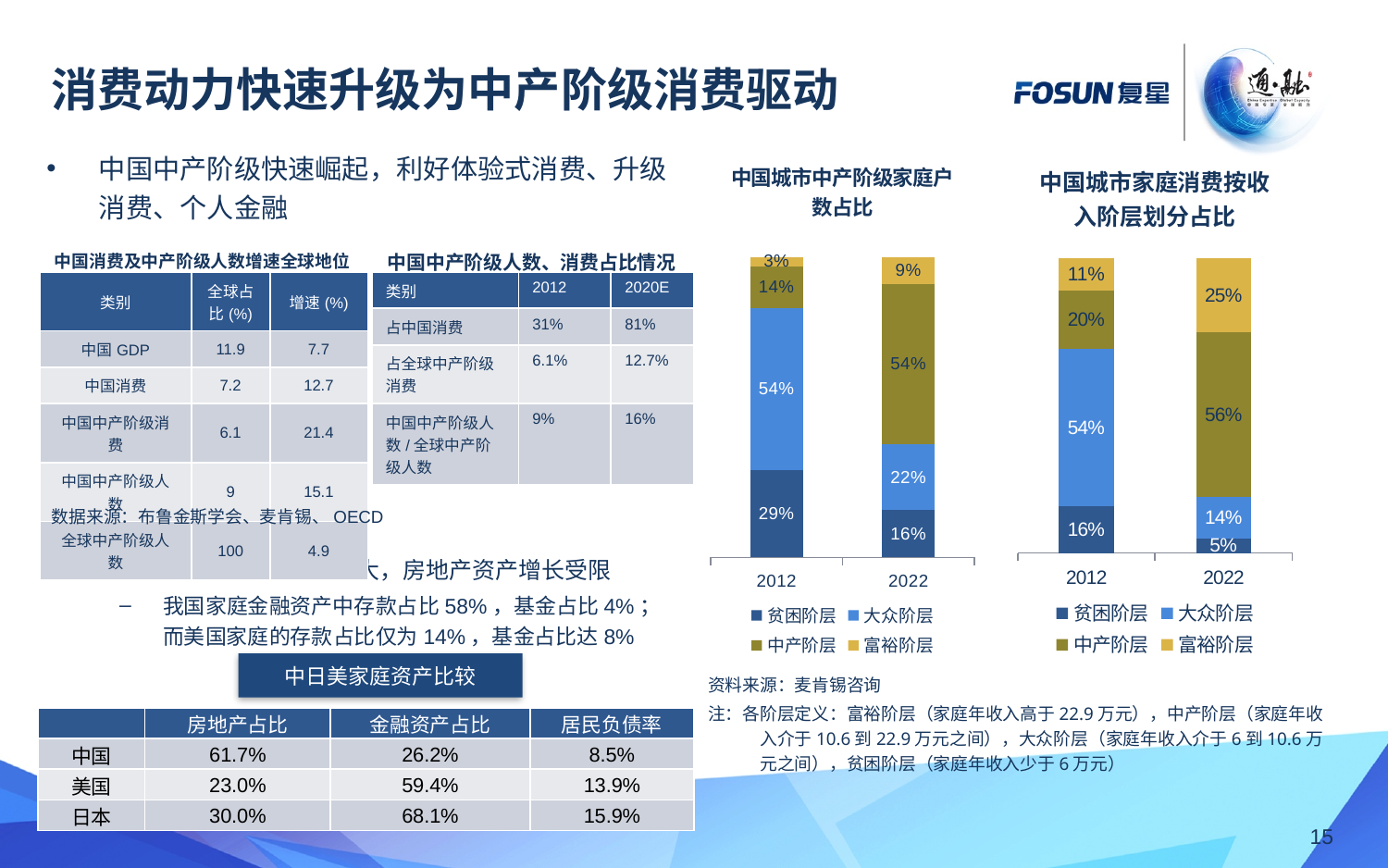
In the chart titled 中国城市中产阶级家庭户数占比, how many series does the legend list? 4 In the chart titled 中国城市中产阶级家庭户数占比, which segment is the largest in the 2012 bar? 大众阶层 In the chart titled 中国城市家庭消费按收入阶层划分占比, what is the value for 富裕阶层 in 2022? 25% In the chart titled 中国城市中产阶级家庭户数占比, what is the difference between the 中产阶层 values for 2022 and 2012? 40% In the chart titled 中国城市家庭消费按收入阶层划分占比, what is the difference between the 贫困阶层 values for 2012 and 2022? 11% In the chart titled 中国城市中产阶级家庭户数占比, what is the value for 贫困阶层 in 2012? 29% In the chart titled 中国城市家庭消费按收入阶层划分占比, which segment is the smallest in the 2022 bar? 贫困阶层 In the chart titled 中国城市家庭消费按收入阶层划分占比, what is the value for 大众阶层 in 2012? 54% In the chart titled 中国城市中产阶级家庭户数占比, what is the value for 富裕阶层 in 2022? 9% In the chart titled 中国城市中产阶级家庭户数占比, what is the value for 中产阶层 in 2022? 54% What type of chart is the chart titled 中国城市家庭消费按收入阶层划分占比? Stacked bar chart In the chart titled 中国城市家庭消费按收入阶层划分占比, is the 中产阶层 value larger in 2012 or 2022? 2022